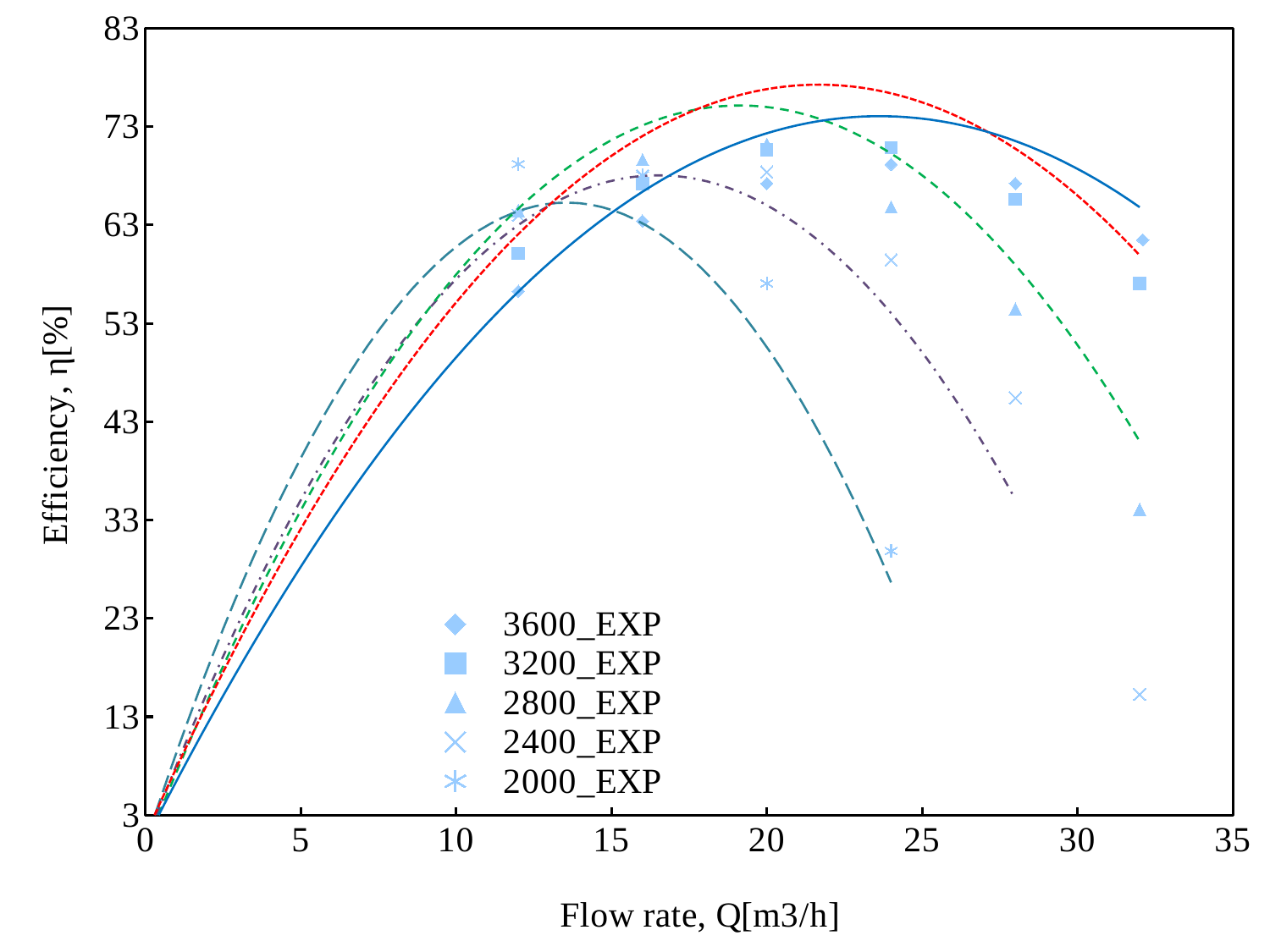
How many series does the legend list? 5 Do the 2000_EXP points rise or fall as the flow rate increases from 12 to 24? fall Is the value for 3200_EXP at a flow rate of 32 greater or less than 53? greater Is the value for 2400_EXP at a flow rate of 32 greater or less than 23? less At a flow rate of 32, which series has the lowest efficiency? 2400_EXP At a flow rate of 24, which is larger: the value for 3600_EXP or the value for 2000_EXP? 3600_EXP Is the value for 2000_EXP at a flow rate of 24 greater or less than 33? less What kind of chart is this? scatter chart At a flow rate of 32, which series has the highest efficiency? 3600_EXP What is the label of the y axis? Efficiency, η[%] What is the label of the x axis? Flow rate, Q[m3/h]